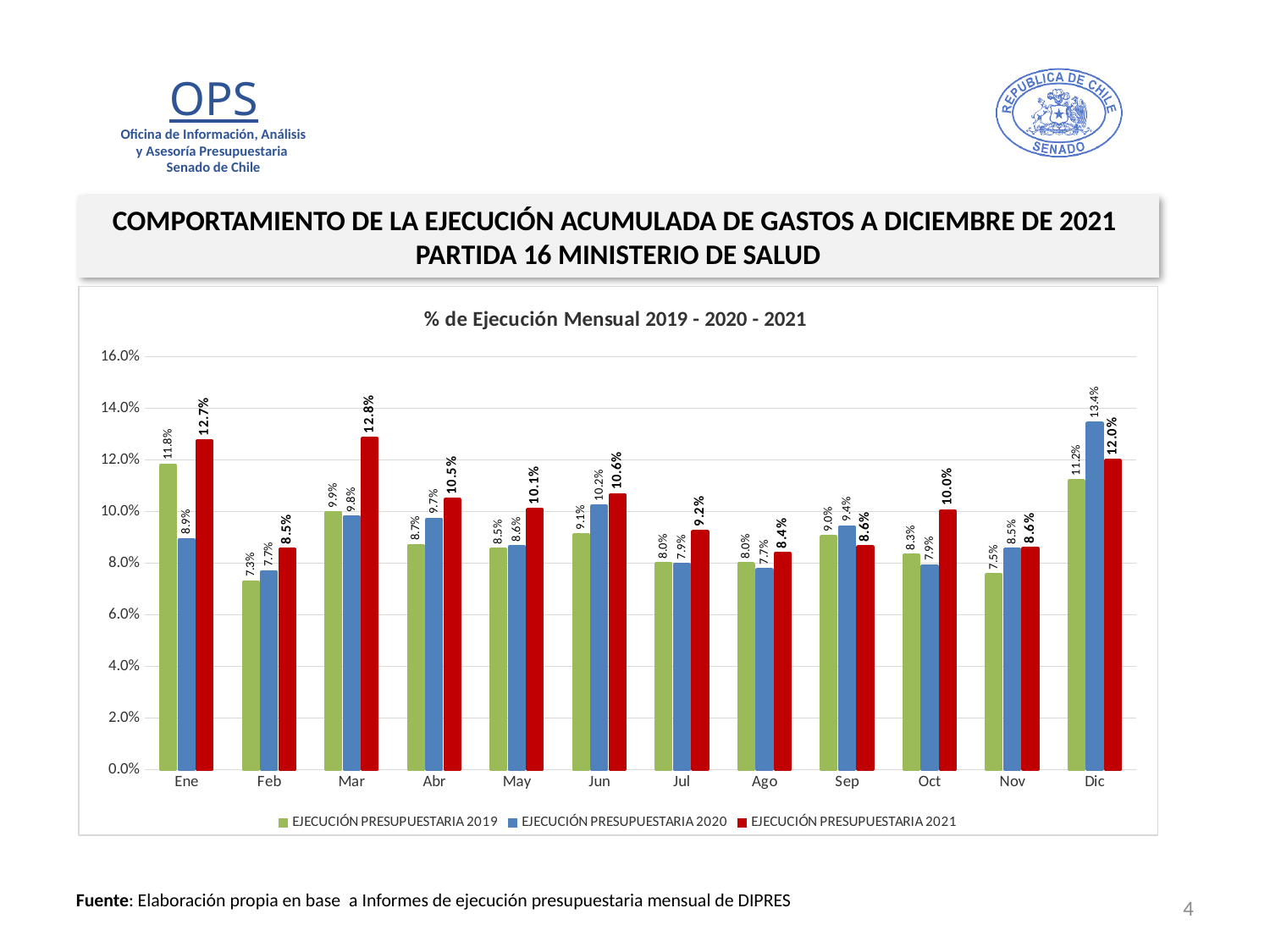
In which month is EJECUCIÓN PRESUPUESTARIA 2020 highest? Dic In which month is EJECUCIÓN PRESUPUESTARIA 2019 lowest? Feb How many series does the legend list? 3 What is the value for EJECUCIÓN PRESUPUESTARIA 2020 in Jun? 10.2% What is the title of the chart? % de Ejecución Mensual 2019 - 2020 - 2021 What is the difference between EJECUCIÓN PRESUPUESTARIA 2021 and EJECUCIÓN PRESUPUESTARIA 2019 in Oct? 1.7% Which is larger in Sep: EJECUCIÓN PRESUPUESTARIA 2020 or EJECUCIÓN PRESUPUESTARIA 2021? EJECUCIÓN PRESUPUESTARIA 2020 What type of chart is shown on the slide? Bar chart What is the value for EJECUCIÓN PRESUPUESTARIA 2021 in Mar? 12.8% How many months are shown on the x axis? 12 Is the value for EJECUCIÓN PRESUPUESTARIA 2021 in Ene greater or less than 12.0%? greater What is the value for EJECUCIÓN PRESUPUESTARIA 2019 in Ene? 11.8%